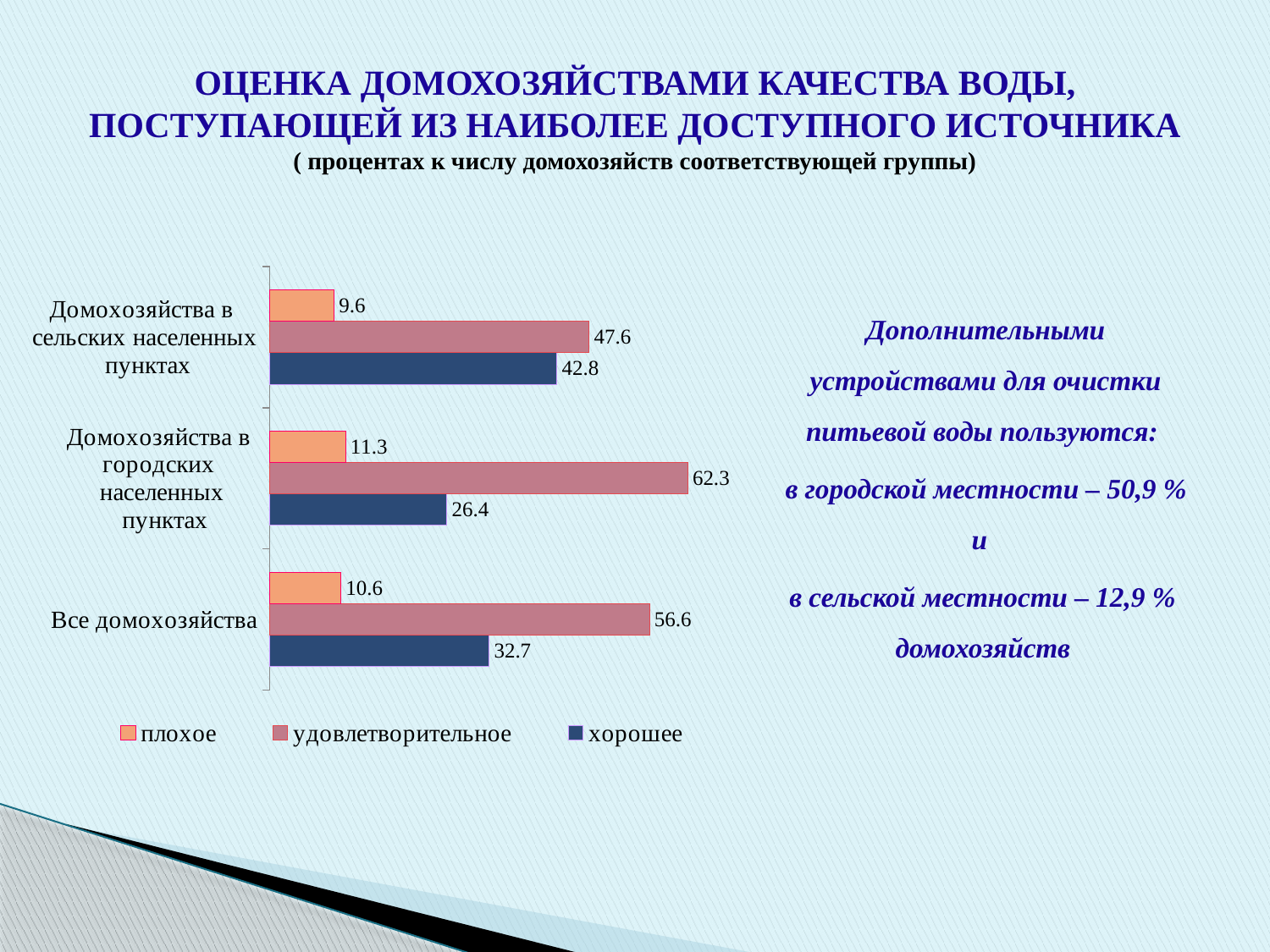
What is the difference between the "удовлетворительное" and "хорошее" values for "Домохозяйства в сельских населенных пунктах"? 4.8 What is the difference between the "удовлетворительное" values for "Домохозяйства в городских населенных пунктах" and "Все домохозяйства"? 5.7 Which is larger: the "плохое" value for "Домохозяйства в городских населенных пунктах" or for "Все домохозяйства"? Домохозяйства в городских населенных пунктах What is the value for "плохое" for "Домохозяйства в сельских населенных пунктах"? 9.6 Which category has the lowest value for "хорошее"? Домохозяйства в городских населенных пунктах Which series is shown in dark blue in the legend? хорошее How many series does the legend list? 3 Which category has the highest value for "удовлетворительное"? Домохозяйства в городских населенных пунктах How many categories are shown on the chart? 3 What is the value for "удовлетворительное" for "Домохозяйства в городских населенных пунктах"? 62.3 What is the value for "хорошее" for "Все домохозяйства"? 32.7 What kind of chart is shown on the slide? Bar chart